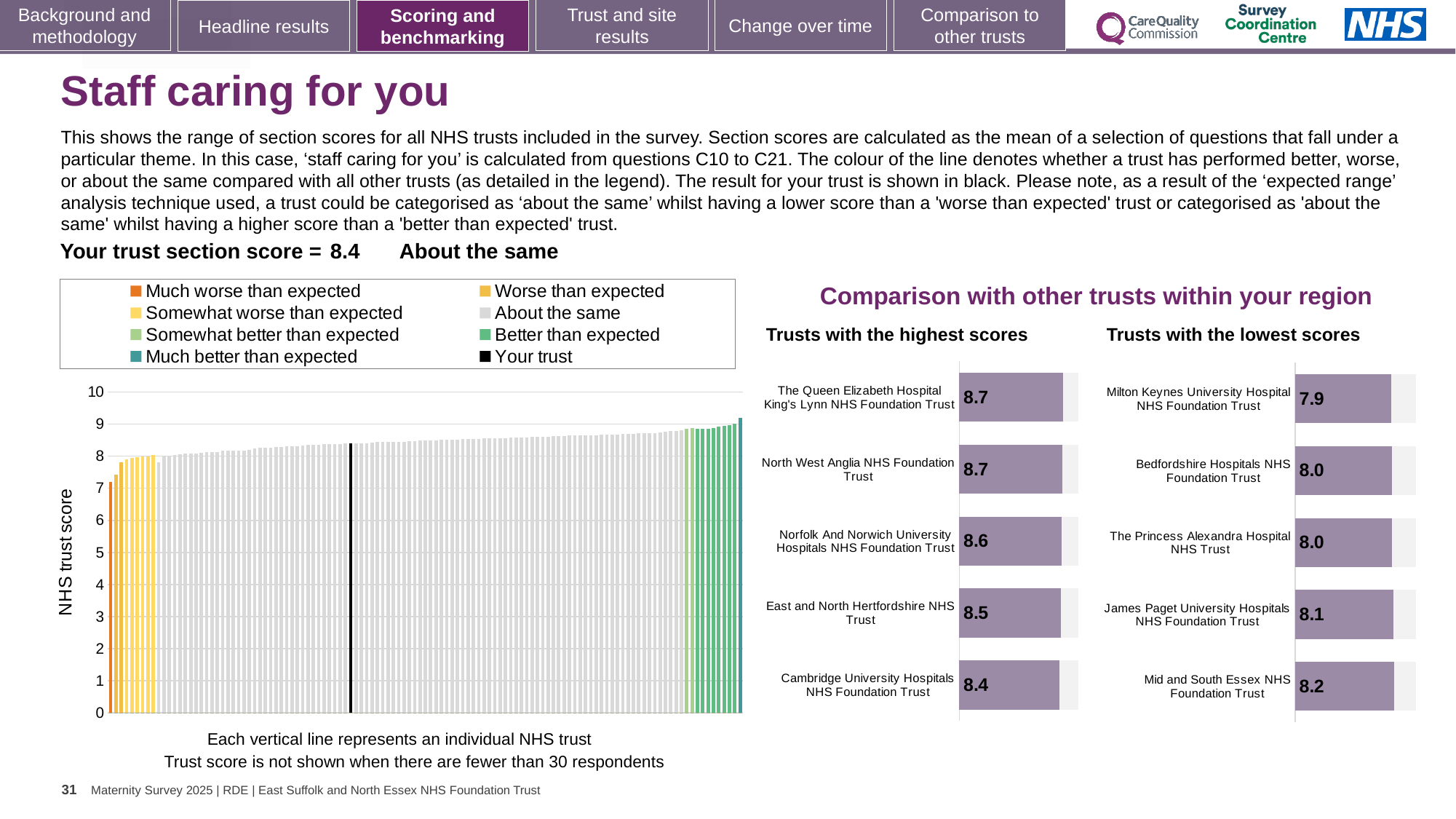
In the large chart on the left, is the value for 'Your trust' (the black line) greater or less than 8? greater In the 'Trusts with the lowest scores' chart, which trust has the highest score? Mid and South Essex NHS Foundation Trust In the 'Trusts with the lowest scores' chart, what is the score for Milton Keynes University Hospital NHS Foundation Trust? 7.9 In the 'Trusts with the highest scores' chart, what is the score for Norfolk And Norwich University Hospitals NHS Foundation Trust? 8.6 In the 'Trusts with the lowest scores' chart, which trust has the lowest score? Milton Keynes University Hospital NHS Foundation Trust In the 'Trusts with the highest scores' chart, which has the larger score: Norfolk And Norwich University Hospitals NHS Foundation Trust or East and North Hertfordshire NHS Trust? Norfolk And Norwich University Hospitals NHS Foundation Trust In the 'Trusts with the highest scores' chart, which trust has the lowest score? Cambridge University Hospitals NHS Foundation Trust What kind of chart is the large chart on the left of the slide? Bar chart How many entries does the legend above the large chart on the left list? 8 In the 'Trusts with the highest scores' chart, what is the difference between the score for The Queen Elizabeth Hospital King's Lynn NHS Foundation Trust and the score for Cambridge University Hospitals NHS Foundation Trust? 0.3 How many trusts are listed in the 'Trusts with the lowest scores' chart? 5 In the 'Trusts with the lowest scores' chart, what is the difference between the score for Mid and South Essex NHS Foundation Trust and the score for Milton Keynes University Hospital NHS Foundation Trust? 0.3